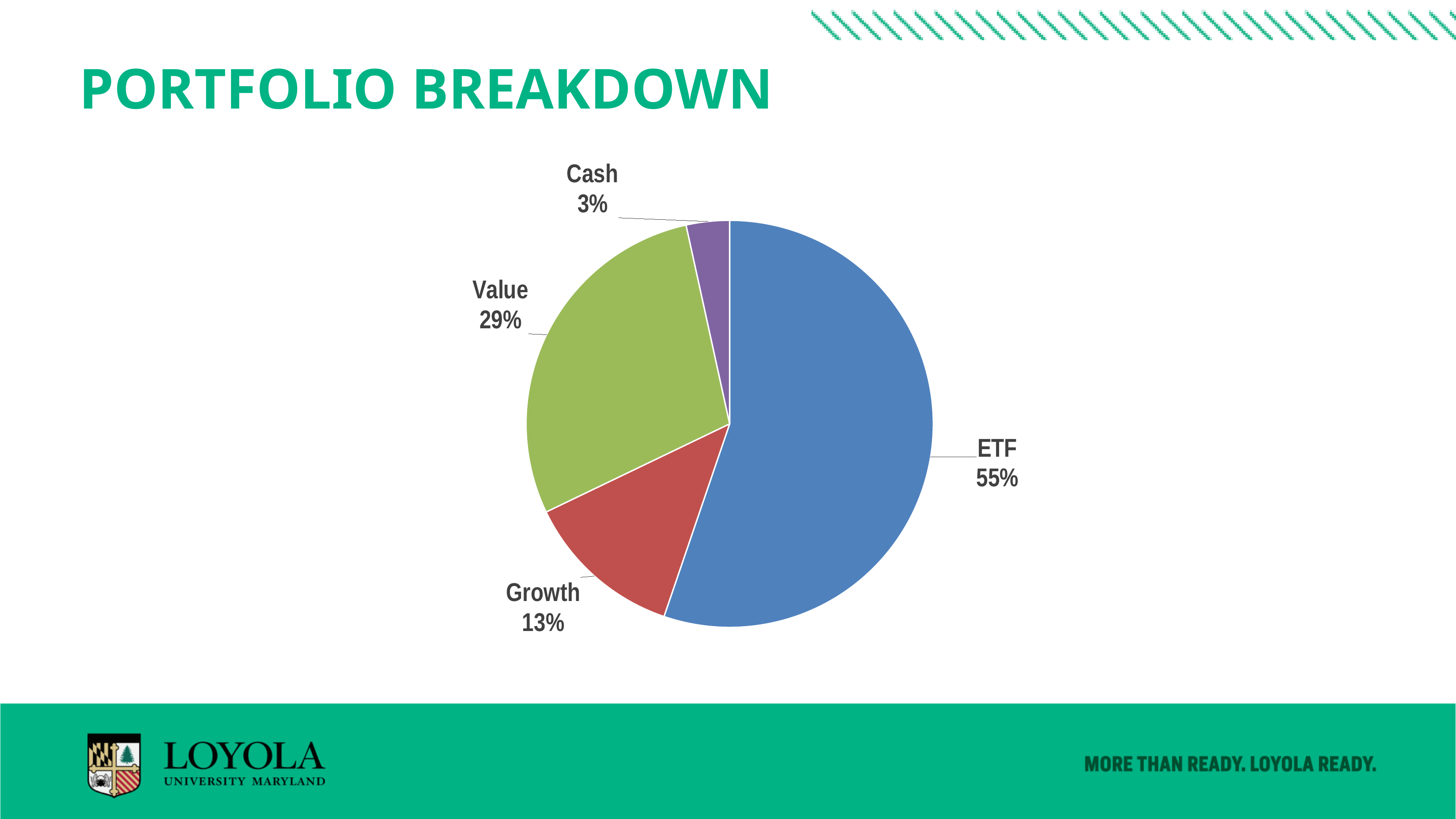
Which category has the smallest slice of the pie? Cash Which category has the largest slice of the pie? ETF What kind of chart is shown on the slide? Pie chart What is the difference in percentage points between ETF and Value? 26 What share of the portfolio is Cash? 3% What share of the portfolio is Growth? 13% How many categories are shown in the pie chart? 4 Which is larger, Value or Growth? Value What is the difference in percentage points between Growth and Cash? 10 What share of the portfolio is ETF? 55% What is the title of the slide? PORTFOLIO BREAKDOWN